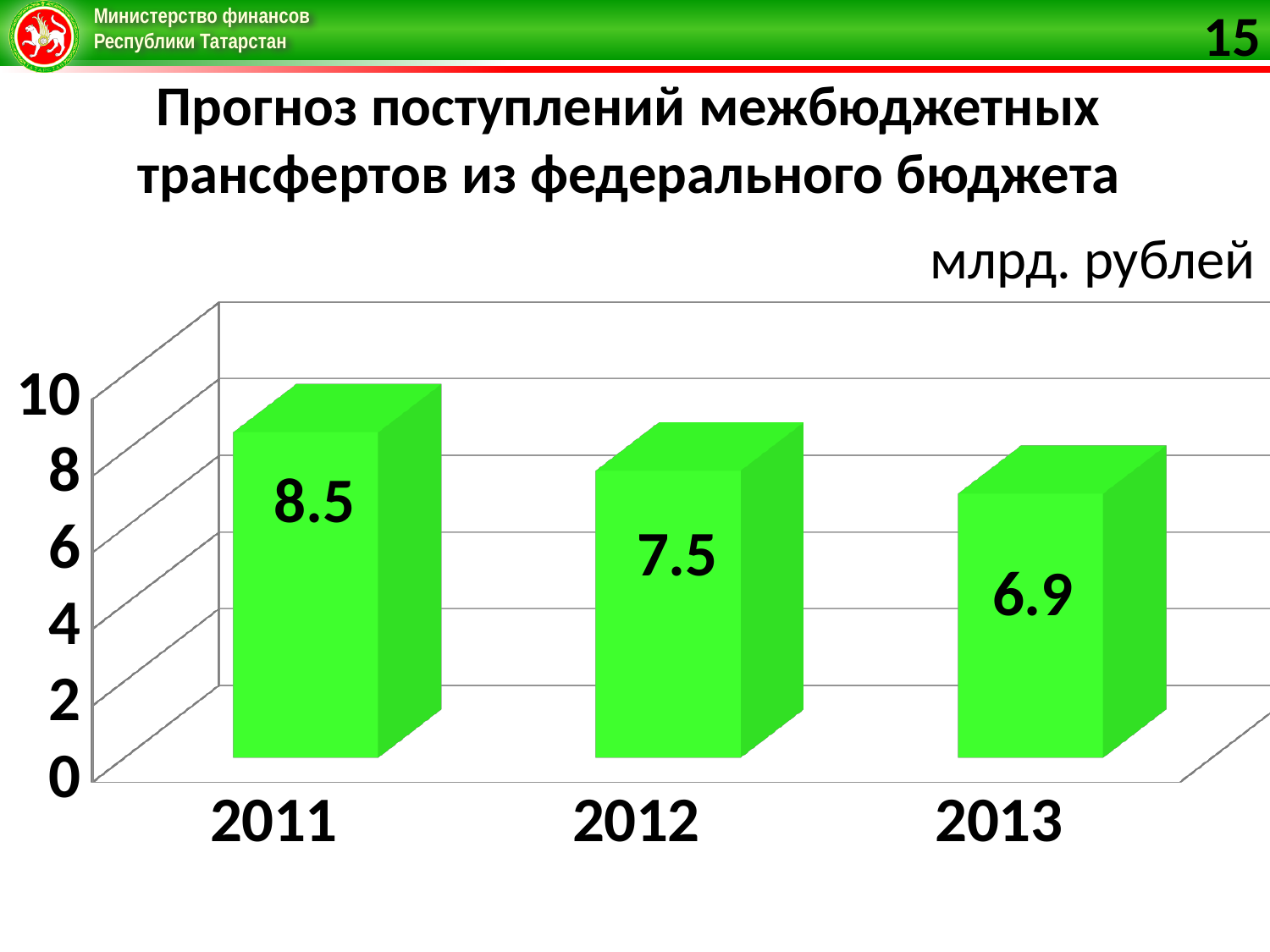
What kind of chart is shown on the slide? bar chart Which is larger, the value for 2012 or the value for 2013? 2012 Which year has the lowest value? 2013 Which year has the highest value? 2011 What is the value for 2011? 8.5 Do the values rise or fall from 2011 to 2013? fall How many years are shown on the chart? 3 What is the value for 2012? 7.5 What is the difference between the values for 2011 and 2013? 1.6 What is the value for 2013? 6.9 What is the difference between the values for 2011 and 2012? 1 What unit is stated for the chart values? млрд. рублей